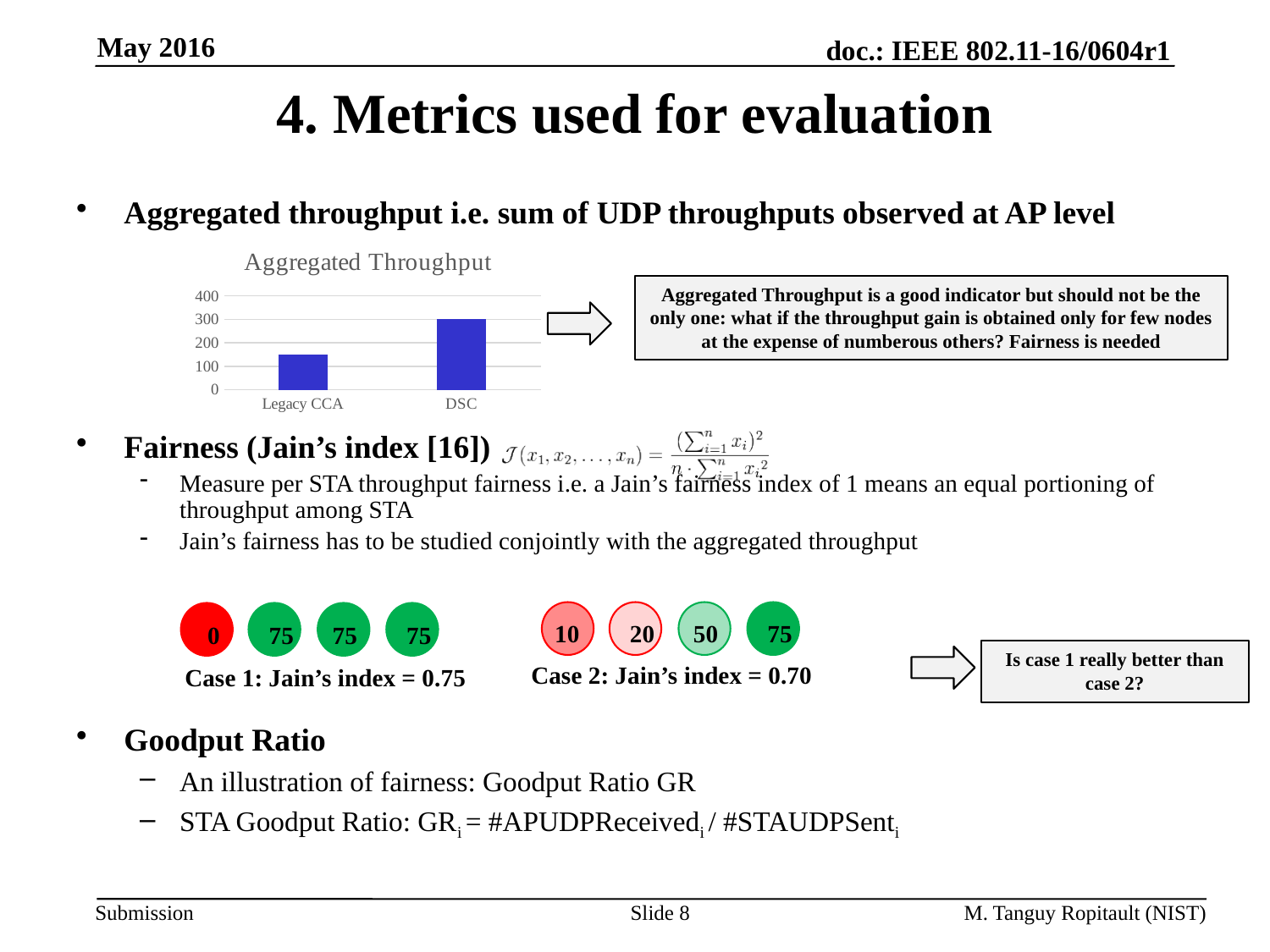
Is the aggregated throughput for Legacy CCA greater or less than 200? less Which category has the lowest aggregated throughput in the chart? Legacy CCA Is the aggregated throughput for DSC greater or less than 400? less How many categories are shown on the x axis of the Aggregated Throughput chart? 2 Do the values in the Aggregated Throughput chart rise or fall from Legacy CCA to DSC? rise What kind of chart is the Aggregated Throughput chart? bar chart Is the aggregated throughput for DSC greater or less than 200? greater What is the title of the bar chart on the slide? Aggregated Throughput What is the highest value shown on the y axis of the Aggregated Throughput chart? 400 In the Aggregated Throughput chart, which is larger: the value for Legacy CCA or the value for DSC? DSC Which category has the highest aggregated throughput in the chart? DSC